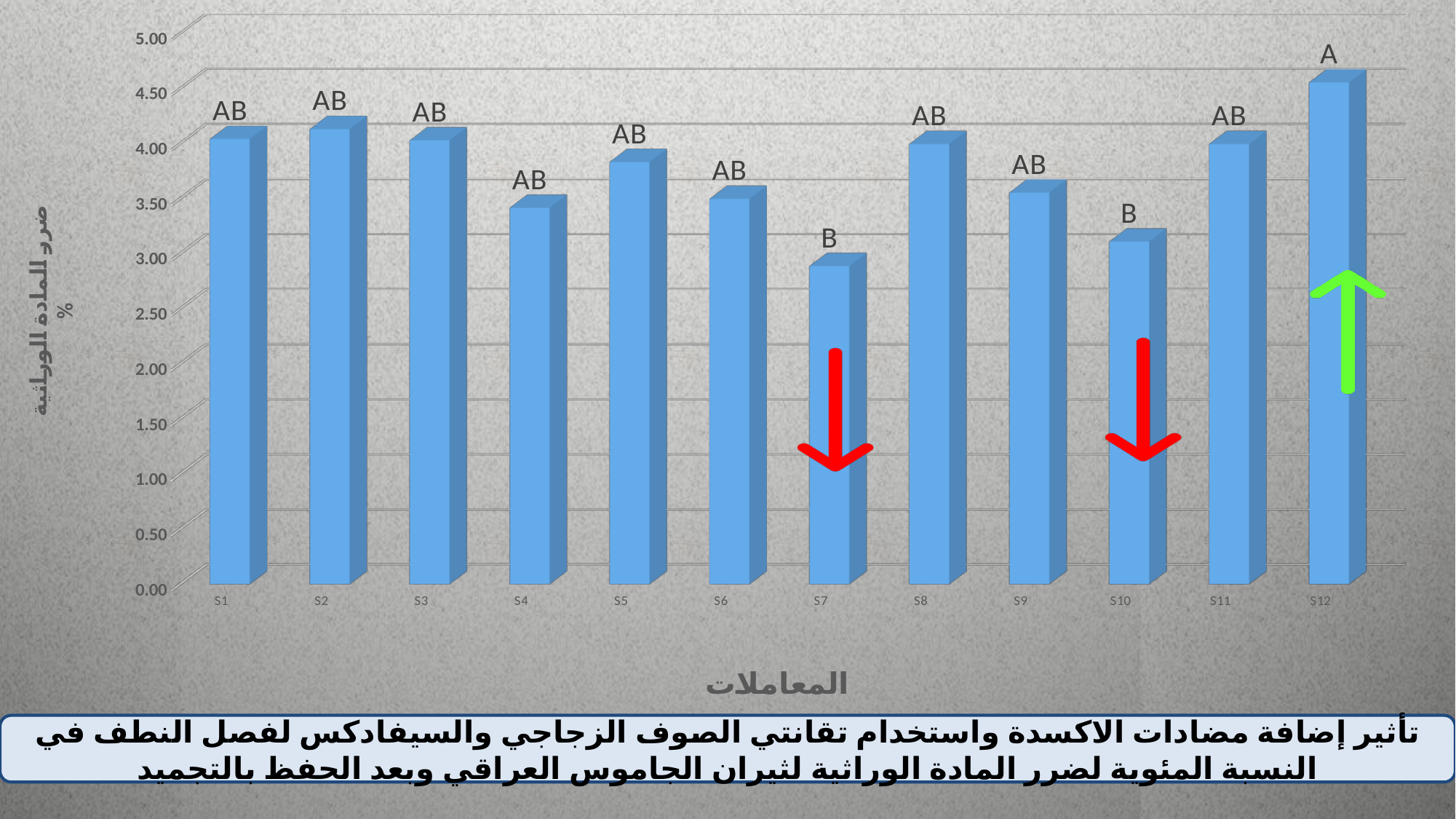
Is the value for S10 greater or less than 3.00? greater Which category has the lowest bar? S7 Is the value for S7 greater or less than 3.00? less Which is larger, the value for S12 or the value for S7? S12 What letter label is printed above the bar for S12? A Which is larger, the value for S4 or the value for S8? S8 Which category has the highest bar? S12 What kind of chart is shown on the slide? bar chart Is the value for S12 greater or less than 4.00? greater How many categories (treatments) are plotted on the x axis? 12 What letter label is printed above the bar for S7? B